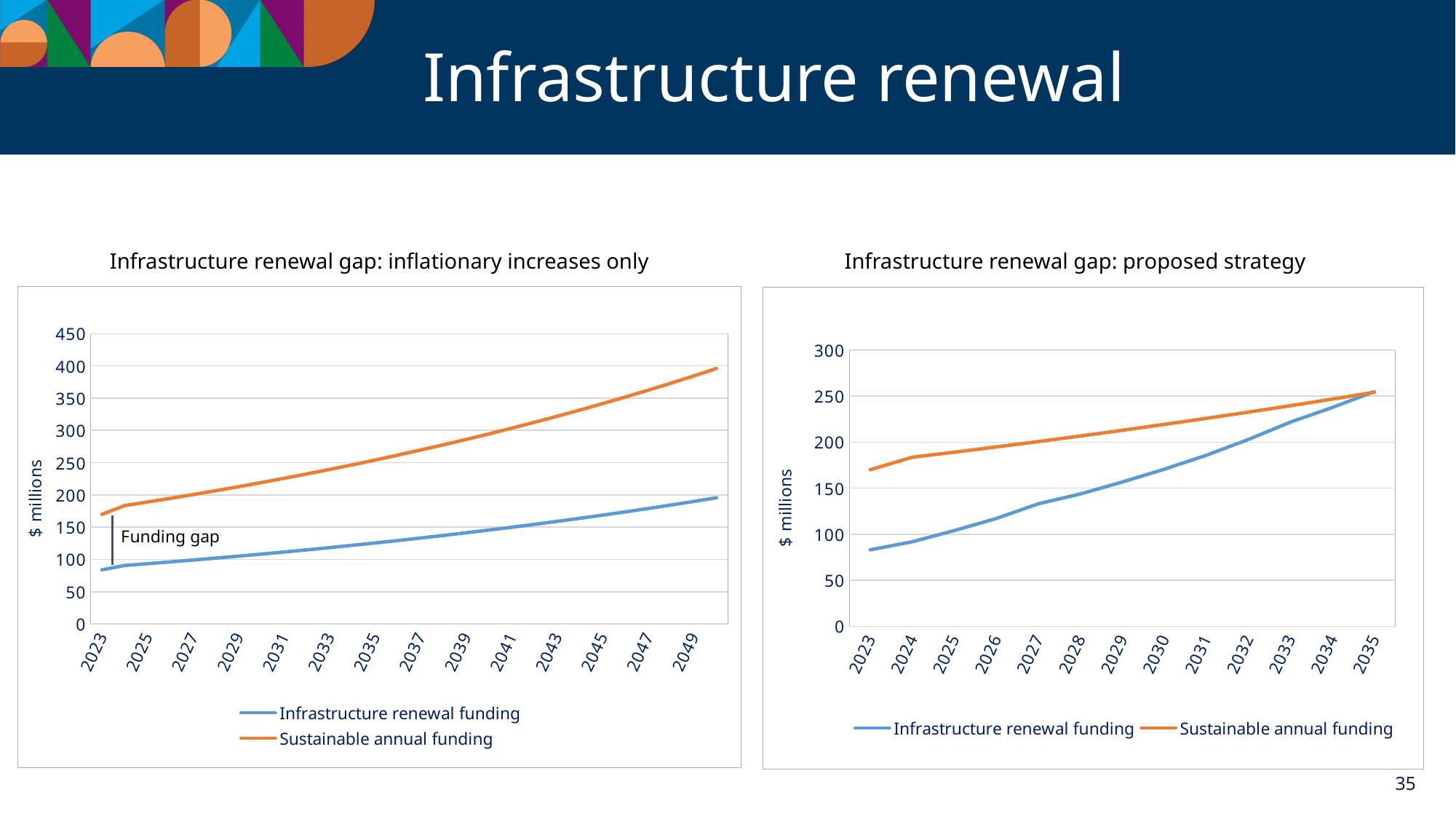
In "Infrastructure renewal gap: inflationary increases only", does Sustainable annual funding rise or fall from 2023 to 2049? Rise How many series does the legend of "Infrastructure renewal gap: proposed strategy" list? 2 In "Infrastructure renewal gap: inflationary increases only", is the value for Sustainable annual funding in 2049 greater or less than 350? greater In "Infrastructure renewal gap: proposed strategy", does Infrastructure renewal funding rise or fall from 2023 to 2035? Rise What kind of chart is "Infrastructure renewal gap: inflationary increases only"? Line chart What colour is the Sustainable annual funding line in the chart on the left? Orange In "Infrastructure renewal gap: inflationary increases only", is the value for Infrastructure renewal funding in 2023 greater or less than 100? less In "Infrastructure renewal gap: proposed strategy", is the value for Sustainable annual funding in 2023 greater or less than 150? greater What is the y-axis label of the chart on the right? $ millions In "Infrastructure renewal gap: proposed strategy", which series is higher in 2023, Infrastructure renewal funding or Sustainable annual funding? Sustainable annual funding In "Infrastructure renewal gap: proposed strategy", how many years are labelled on the x axis? 13 In "Infrastructure renewal gap: inflationary increases only", which series is higher in 2049, Infrastructure renewal funding or Sustainable annual funding? Sustainable annual funding